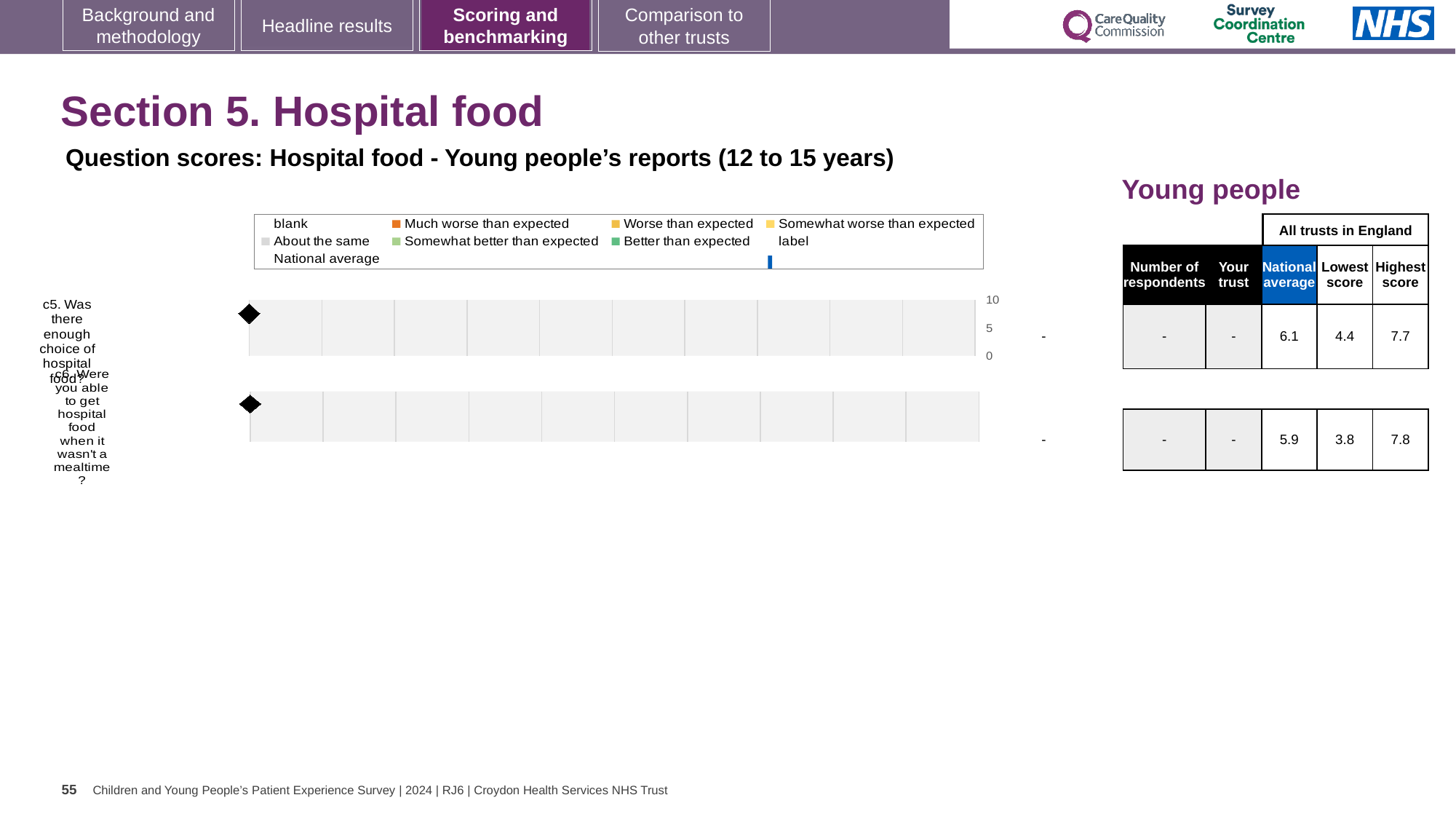
Which question has the higher national average score, c5 or c6? c5 In the table next to the chart, what is the national average score for question c6 (Were you able to get hospital food when it wasn't a mealtime?)? 5.9 In the table next to the chart, what is the national average score for question c5 (Was there enough choice of hospital food?)? 6.1 What colour is the 'Much worse than expected' legend entry? orange What kind of chart is shown on the slide? bar chart Which question has the lower lowest score, c5 or c6? c6 What is the maximum value shown on the chart's score axis? 10 In the table next to the chart, what is the lowest score for question c5? 4.4 What is the difference between the highest score and the lowest score for question c6? 4.0 In the table next to the chart, what is the highest score for question c6? 7.8 What is the difference between the highest score and the lowest score for question c5? 3.3 How many survey questions (categories) are plotted on the chart? 2